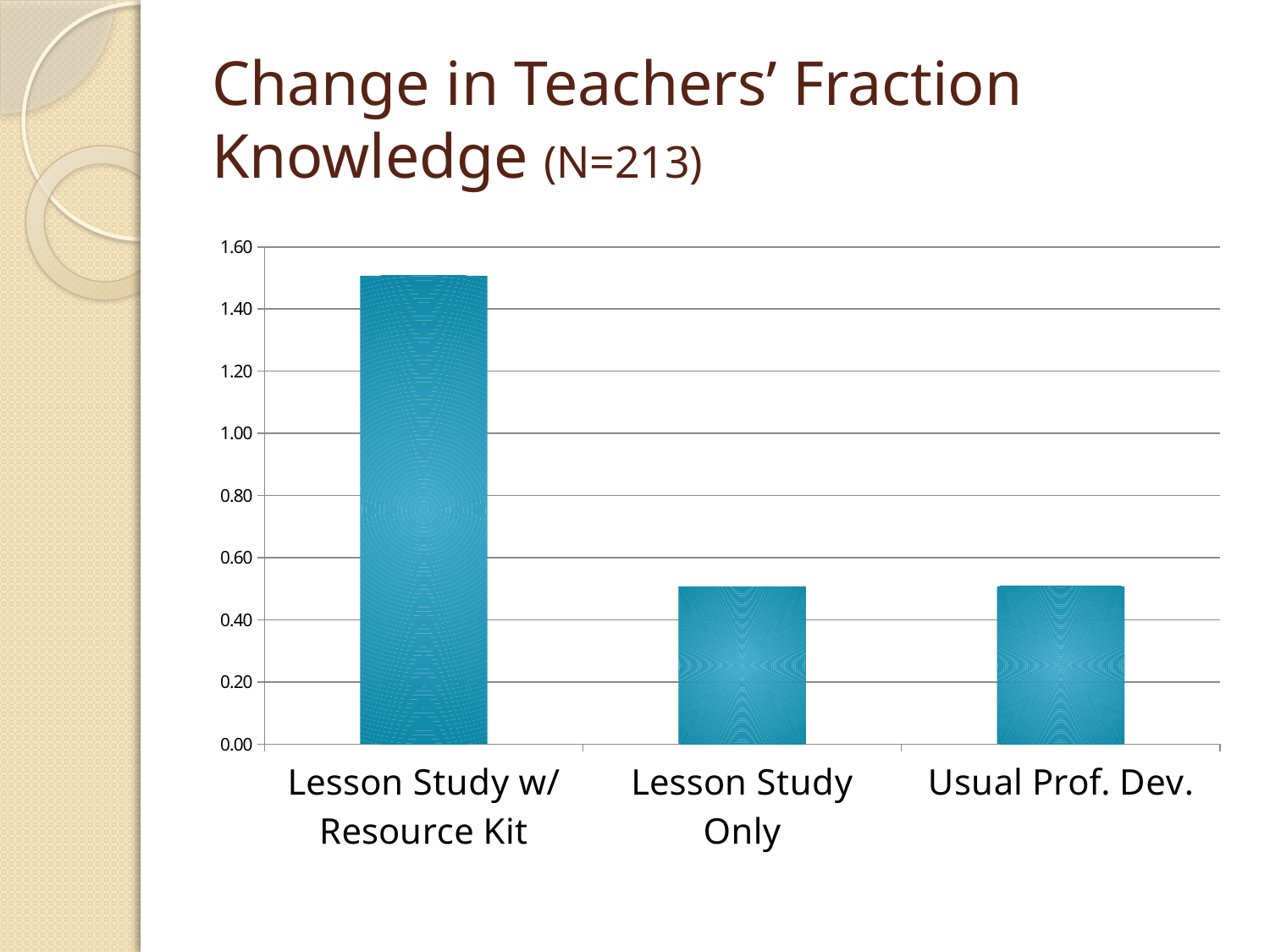
Is the value for Usual Prof. Dev. greater or less than 1.00? less Is the value for Lesson Study Only greater or less than 0.40? greater How many categories are shown on the x axis of the chart? 3 Is the value for Usual Prof. Dev. greater or less than 0.60? less Which is larger, the value for Lesson Study Only or the value for Lesson Study w/ Resource Kit? Lesson Study w/ Resource Kit What kind of chart is shown on the slide? bar chart What is the sample size (N) given in the slide title? N=213 Which category has the highest bar? Lesson Study w/ Resource Kit Which is larger, the value for Lesson Study w/ Resource Kit or the value for Usual Prof. Dev.? Lesson Study w/ Resource Kit